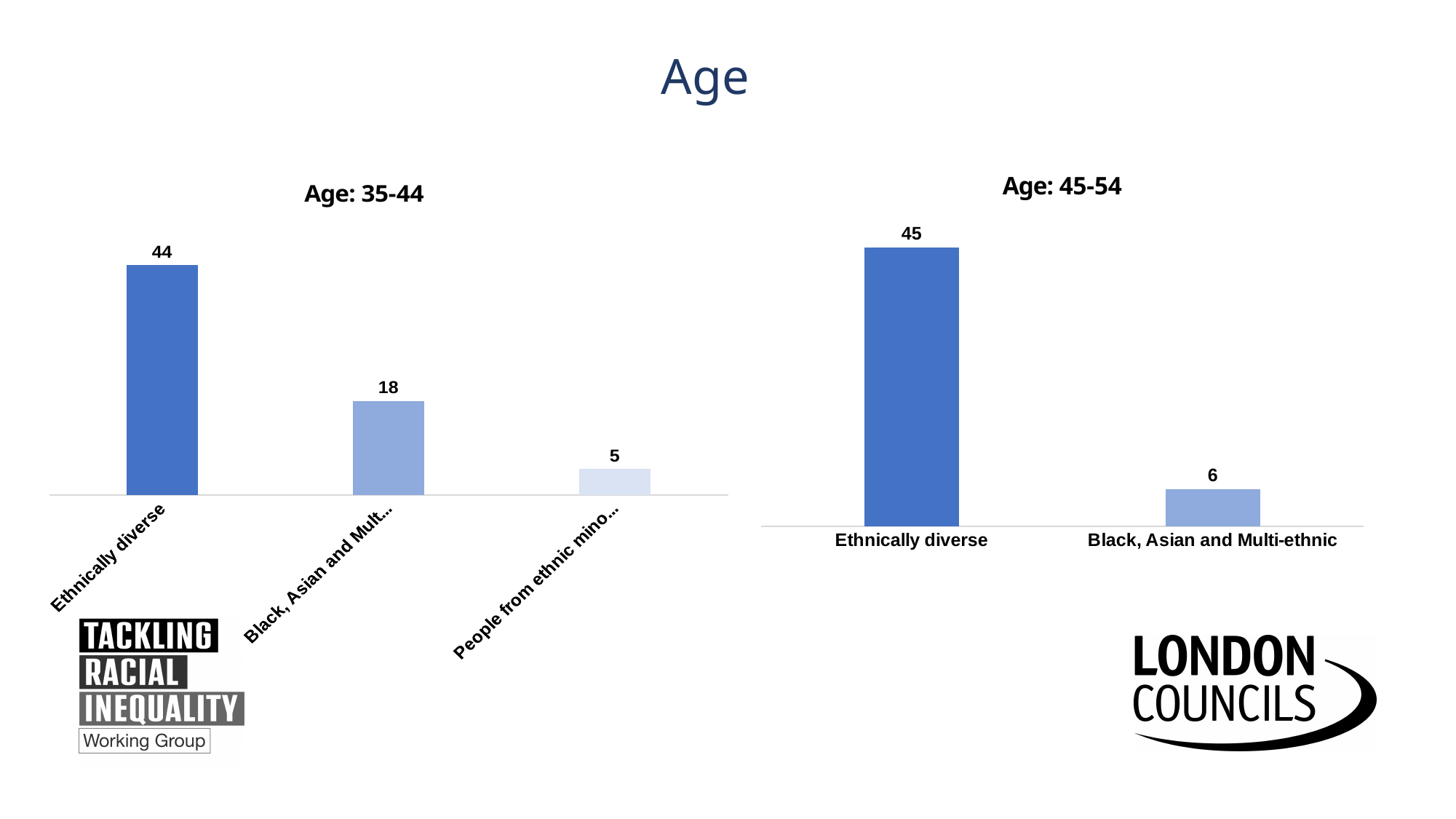
In the 'Age: 35-44' chart, what is the value for the category labelled 'Black, Asian and Mult...'? 18 What kind of chart is the 'Age: 45-54' chart? Bar chart In the 'Age: 35-44' chart, which category has the highest value? Ethnically diverse In the 'Age: 45-54' chart, what is the value for Ethnically diverse? 45 In the 'Age: 35-44' chart, what is the value for the category labelled 'People from ethnic mino...'? 5 How many categories are shown in the 'Age: 35-44' chart? 3 In the 'Age: 35-44' chart, what is the difference between the values for Ethnically diverse and 'Black, Asian and Mult...'? 26 Which is larger: the Ethnically diverse value in the 'Age: 35-44' chart or the Ethnically diverse value in the 'Age: 45-54' chart? Age: 45-54 In the 'Age: 35-44' chart, what is the value for Ethnically diverse? 44 In the 'Age: 45-54' chart, what is the value for Black, Asian and Multi-ethnic? 6 In the 'Age: 45-54' chart, what is the difference between the values for Ethnically diverse and Black, Asian and Multi-ethnic? 39 In the 'Age: 45-54' chart, which category has the lowest value? Black, Asian and Multi-ethnic